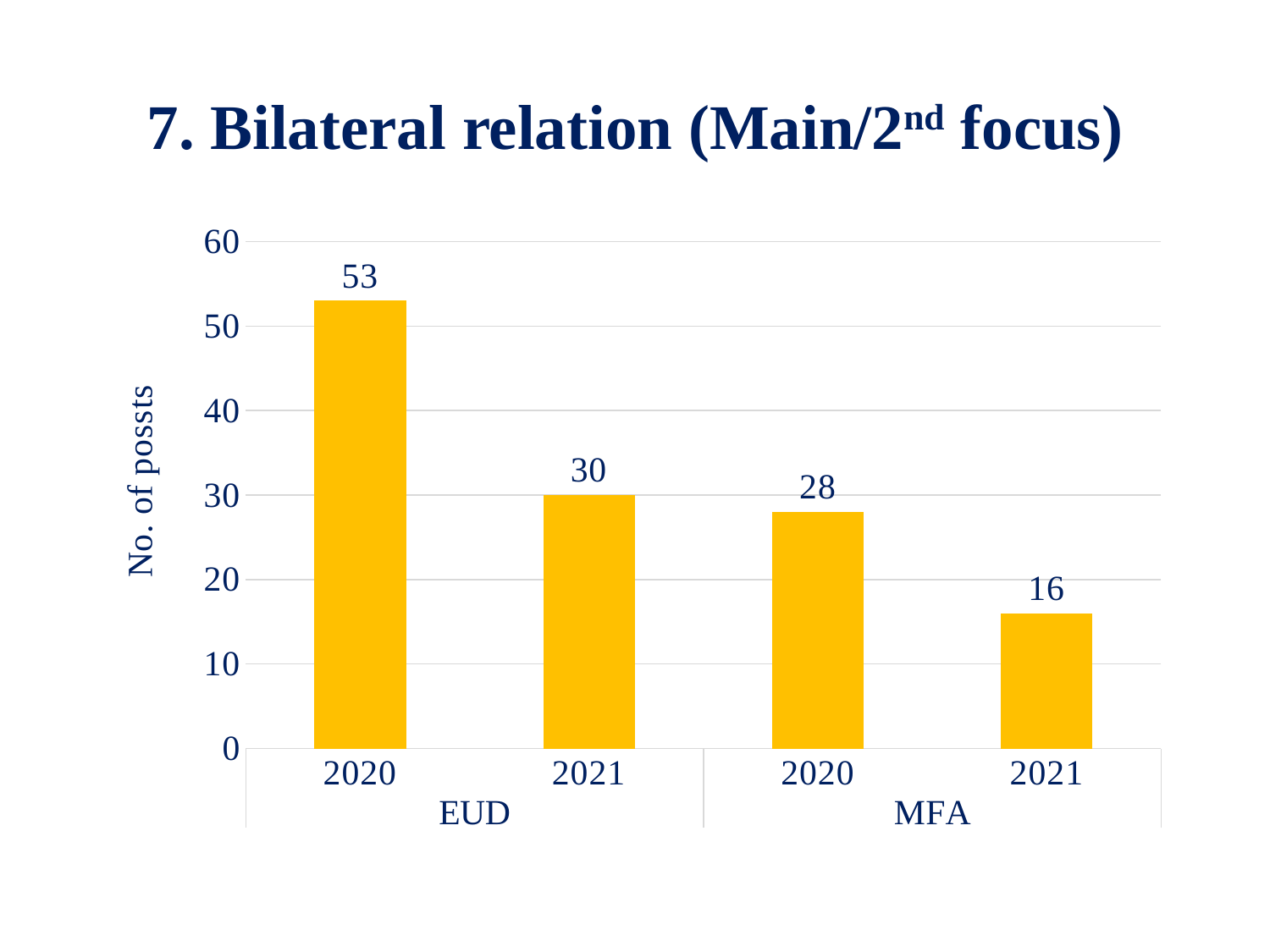
How many bars are plotted in the chart? 4 What is the number of posts for MFA in 2021? 16 What is the difference between MFA 2020 and MFA 2021? 12 Which bar has the lowest value? MFA 2021 What kind of chart is shown on the slide? Bar chart What is the label of the vertical axis? No. of possts Which is larger, EUD 2021 or MFA 2020? EUD 2021 What is the difference between EUD 2020 and EUD 2021? 23 What is the number of posts for EUD in 2021? 30 What is the number of posts for EUD in 2020? 53 What is the number of posts for MFA in 2020? 28 Which bar has the highest value? EUD 2020